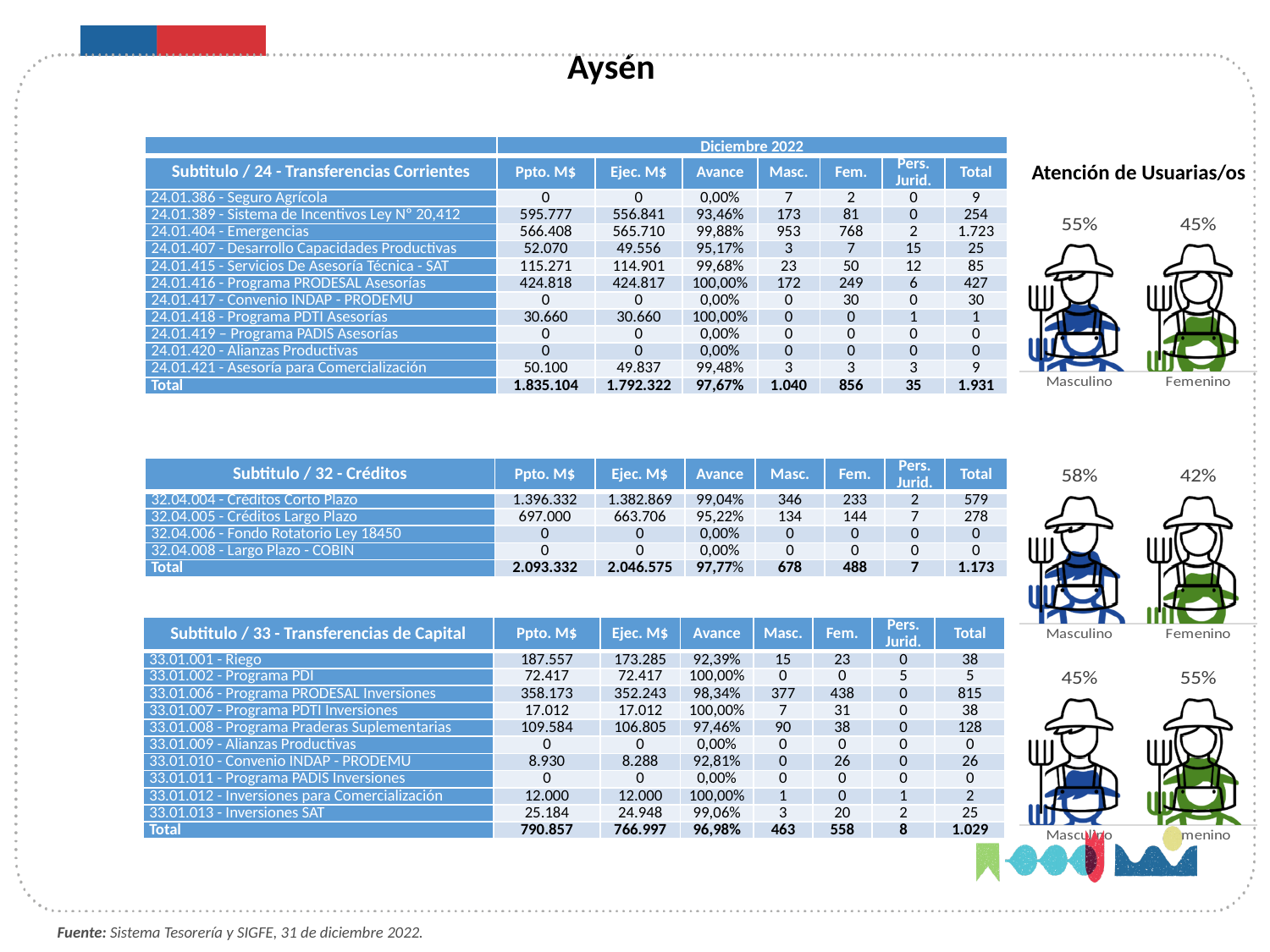
How many categories does each 'Atención de Usuarias/os' pictograph show? 2 What is the title shown above the pictographs on the right side of the slide? Atención de Usuarias/os In the middle pictograph (next to Subtítulo 32 - Créditos), what percentage is shown for Masculino? 58% In the bottom pictograph (next to Subtítulo 33 - Transferencias de Capital), what percentage is shown for Masculino? 45% In the top 'Atención de Usuarias/os' pictograph (next to Subtítulo 24), what percentage is shown for Femenino? 45% In the bottom pictograph (next to Subtítulo 33 - Transferencias de Capital), what percentage is shown for Femenino? 55% In the middle pictograph (next to Subtítulo 32 - Créditos), what is the difference between the Masculino and Femenino percentages? 16% In the top 'Atención de Usuarias/os' pictograph (next to Subtítulo 24), what percentage is shown for Masculino? 55% In the top pictograph (next to Subtítulo 24), what is the difference between the Masculino and Femenino percentages? 10% In the middle pictograph (next to Subtítulo 32 - Créditos), what percentage is shown for Femenino? 42% In the bottom pictograph (next to Subtítulo 33 - Transferencias de Capital), which category has the higher percentage, Masculino or Femenino? Femenino In the middle pictograph (next to Subtítulo 32 - Créditos), which category has the higher percentage, Masculino or Femenino? Masculino